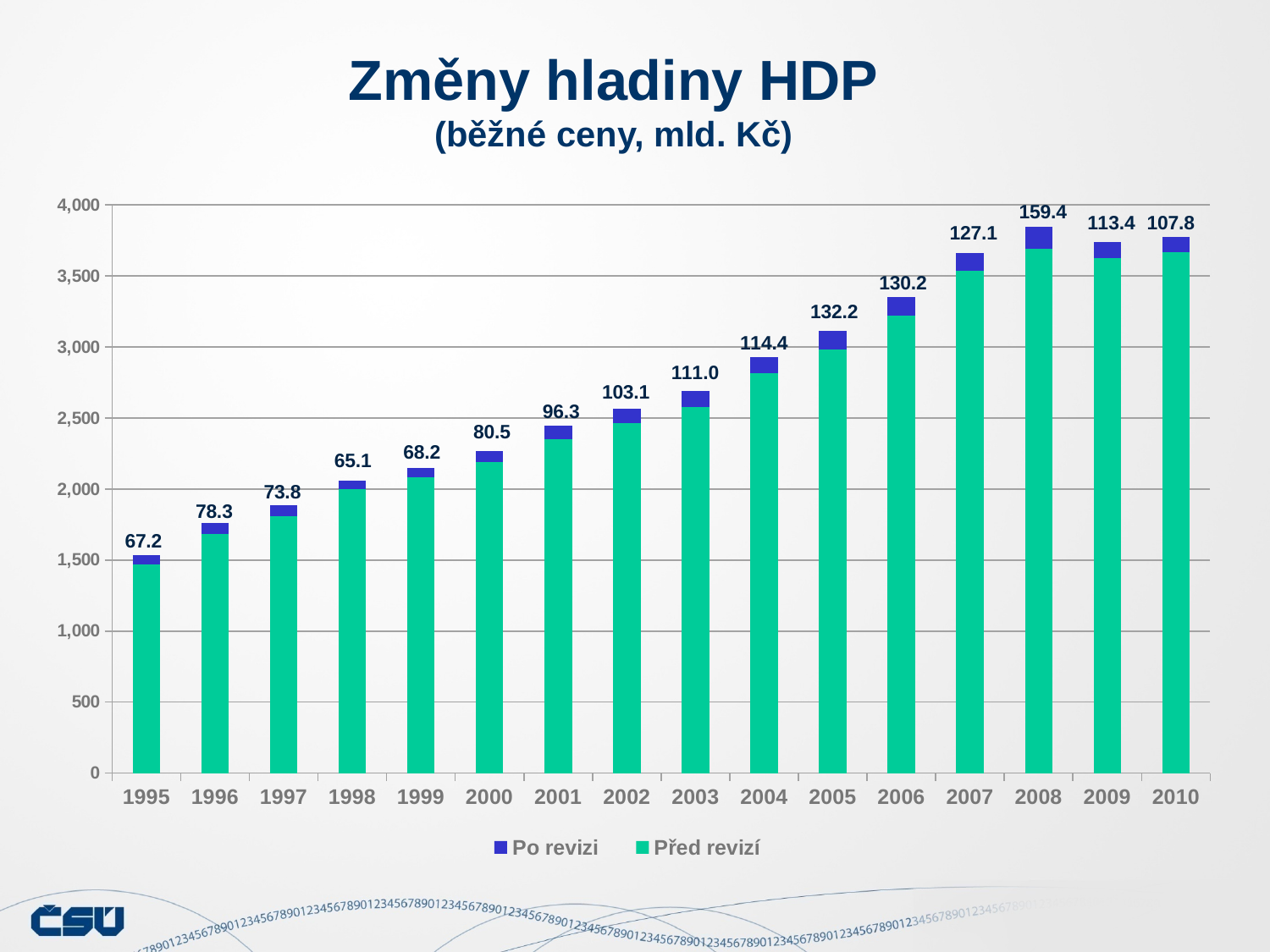
Is the total height of the 2000 bar greater or less than 2,000? greater What is the data label shown for 2008? 159.4 How many series does the legend list? 2 Is the total height of the 2010 bar greater or less than 3,500? greater What type of chart is shown on the slide? Stacked bar chart What is the difference between the labelled values for 2008 and 2009? 46.0 Which year has the highest labelled value? 2008 What is the data label shown for 1995? 67.2 Which year has the larger labelled value, 2005 or 2006? 2005 What is the data label shown for 2003? 111.0 How many years are shown on the x axis? 16 Which year has the lowest labelled value? 1998